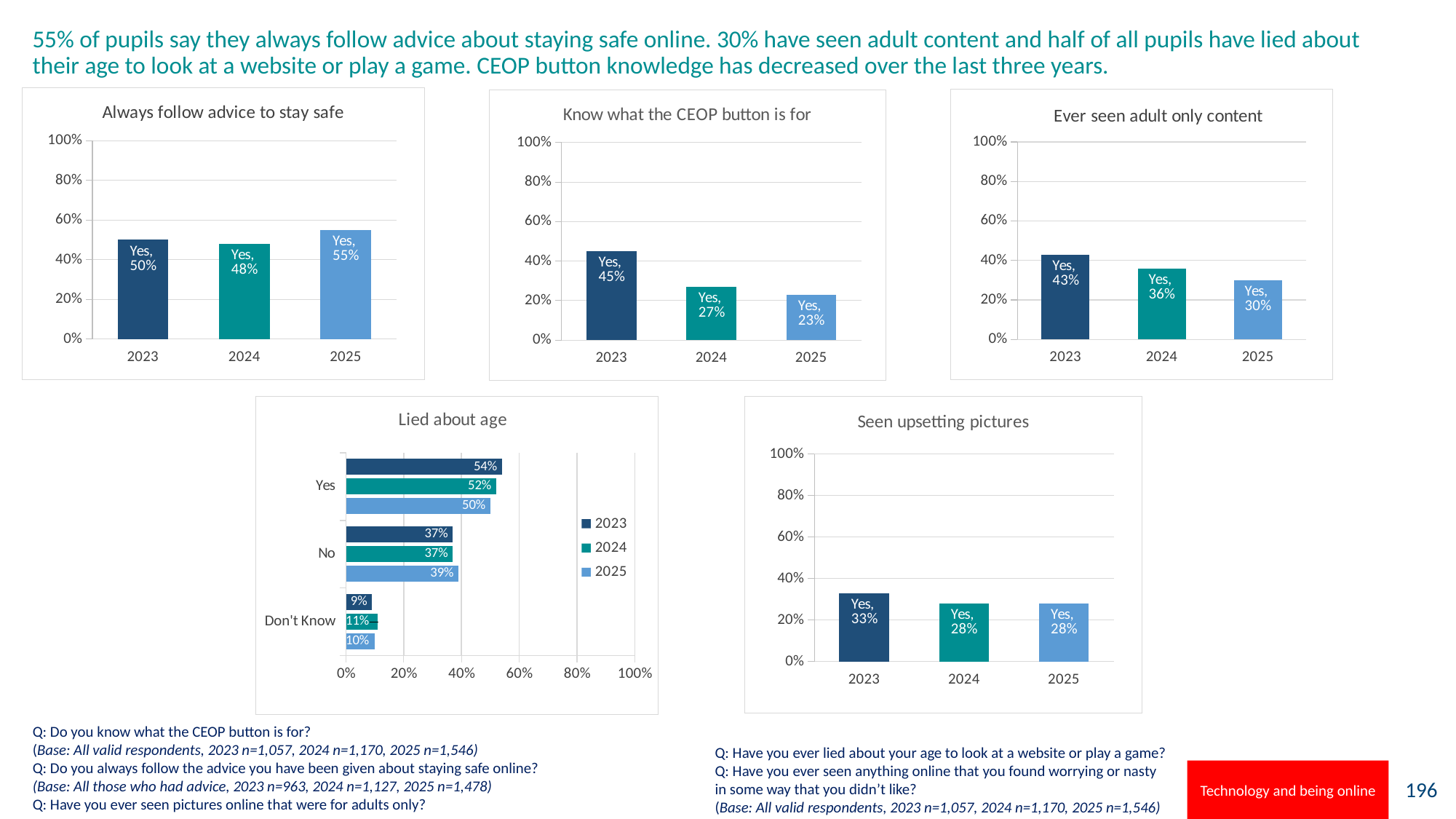
In the 'Know what the CEOP button is for' chart, what is the difference between the 2023 and 2025 values? 22% In the 'Always follow advice to stay safe' chart, what is the value for 2025? 55% In the 'Lied about age' chart, what is the 2024 value for 'No'? 37% In the 'Seen upsetting pictures' chart, which is larger, the value for 2023 or the value for 2024? 2023 In the 'Lied about age' chart, how many series does the legend list? 3 In the 'Lied about age' chart, which response category has the lowest values? Don't Know In the 'Ever seen adult only content' chart, what is the value for 2024? 36% In the 'Ever seen adult only content' chart, do the values rise or fall from 2023 to 2025? fall How many years are shown on the x axis of the 'Always follow advice to stay safe' chart? 3 What kind of chart is the 'Lied about age' chart? bar chart In the 'Seen upsetting pictures' chart, is the value for 2025 greater or less than 40%? less In the 'Know what the CEOP button is for' chart, which year has the highest value? 2023